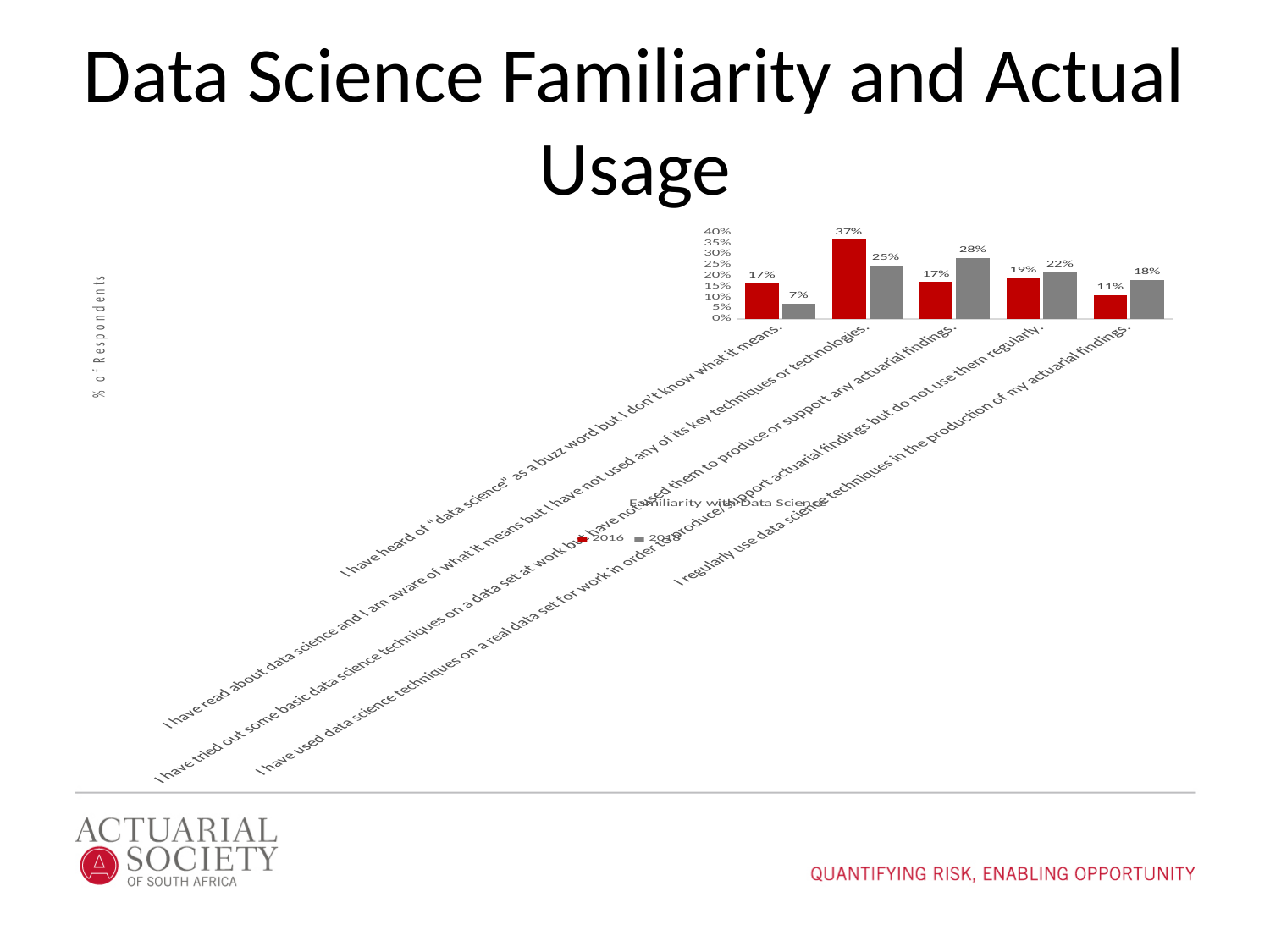
What is the difference between the 2016 and grey (second series) values for "I have heard of 'data science' as a buzz word but I don't know what it means"? 10% How many series does the chart's legend list? 2 What is the 2016 value for "I regularly use data science techniques in the production of my actuarial findings"? 11% Which category has the lowest grey (second series) value? I have heard of "data science" as a buzz word but I don't know what it means. Which category has the highest 2016 value? I have read about data science and I am aware of what it means but I have not used any of its key techniques or technologies. For "I regularly use data science techniques in the production of my actuarial findings", which is larger: the 2016 value or the grey (second series) value? the grey (second series) value What is the title of the chart's x axis? Familiarity with Data Science What is the 2016 value for "I have heard of 'data science' as a buzz word but I don't know what it means"? 17% What is the grey (second series) value for "I have tried out some basic data science techniques on a data set at work but have not used them to produce or support any actuarial findings"? 28% What kind of chart is shown on the slide? bar chart What is the 2016 value for "I have read about data science and I am aware of what it means but I have not used any of its key techniques or technologies"? 37% How many categories are shown on the x axis of the chart? 5